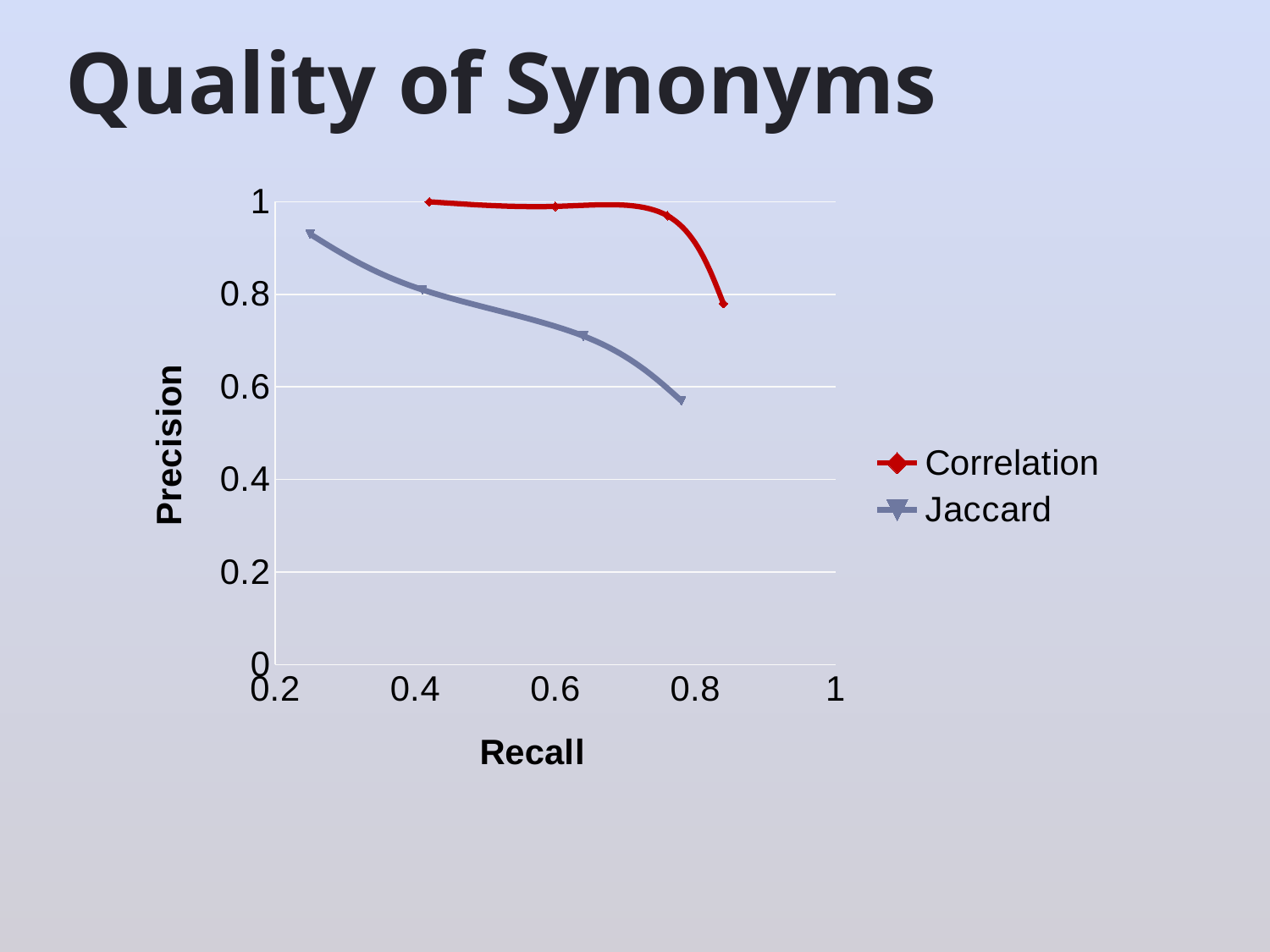
How many data points are plotted for the Correlation series? 4 How many data points are plotted for the Jaccard series? 4 How many series does the legend list? 2 What kind of chart is shown on the slide? line chart Is the precision of the first Correlation point (at the lowest recall) greater or less than 0.8? greater Which series has the higher precision across the plotted recall range, Correlation or Jaccard? Correlation Is the precision of the first Jaccard point (at the lowest recall) greater or less than 0.8? greater What is the title of the chart on the slide? Quality of Synonyms Does precision for the Correlation series rise or fall as recall increases? fall Is the precision of the Jaccard point at recall of about 0.64 greater or less than 0.8? less What are the two series named in the legend? Correlation and Jaccard Does precision for the Jaccard series rise or fall as recall increases? fall